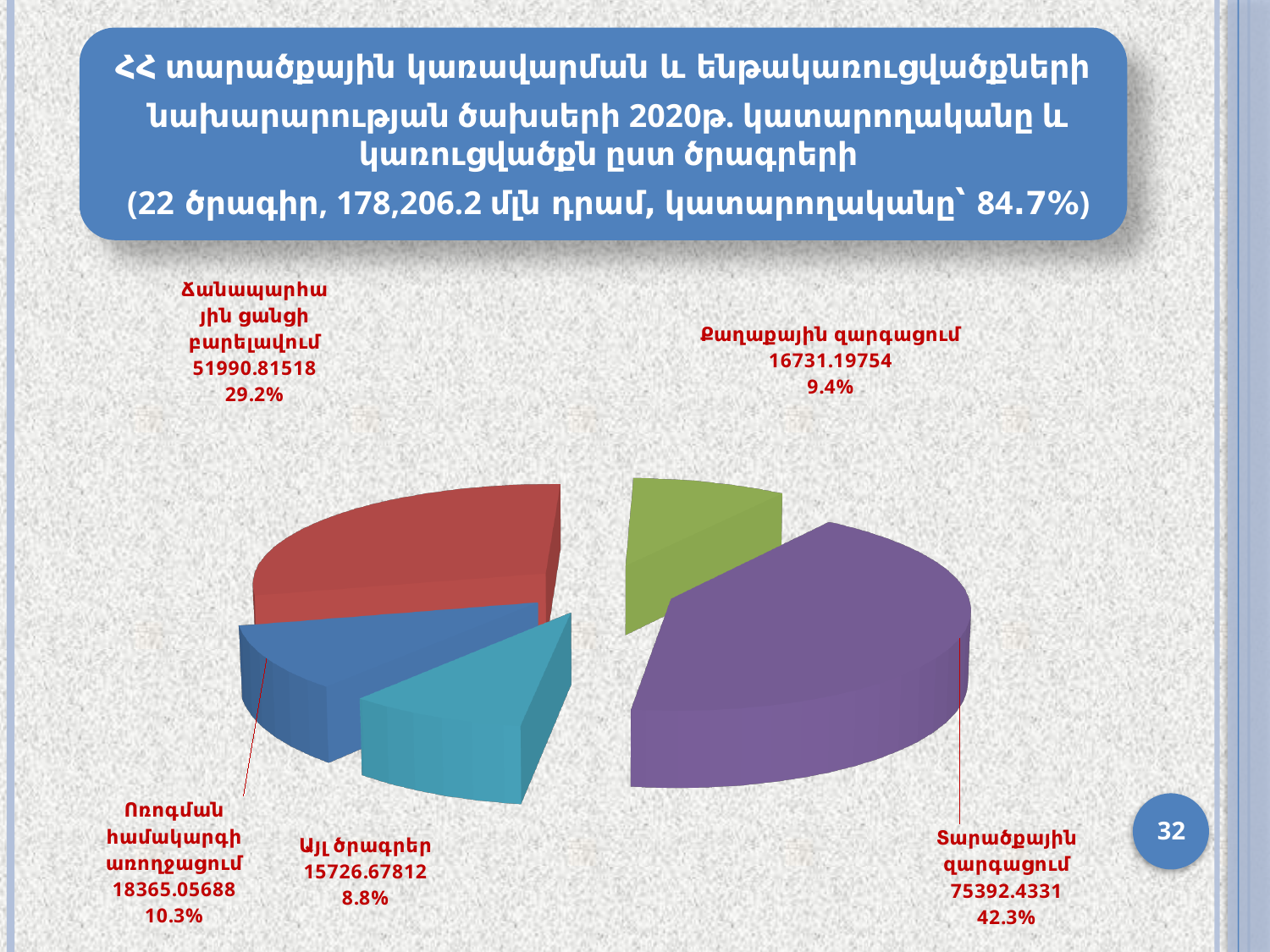
What is the value shown for Տարածքային զարգացում? 75392.4331 What share of the pie does Քաղաքային զարգացում represent? 9.4% Which category has the smallest slice of the pie? Այլ ծրագրեր What is the difference in percentage share between Տարածքային զարգացում and Ճանապարհային ցանցի բարելավում? 13.1% What colour is the slice for Տարածքային զարգացում? Purple What is the value shown for Ճանապարհային ցանցի բարելավում? 51990.81518 What type of chart is shown on the slide? Pie chart Which is larger, the value for Ոռոգման համակարգի առողջացում or the value for Քաղաքային զարգացում? Ոռոգման համակարգի առողջացում Which category has the largest slice of the pie? Տարածքային զարգացում What is the value shown for Ոռոգման համակարգի առողջացում? 18365.05688 How many slices does the pie chart have? 5 What share of the pie does Այլ ծրագրեր represent? 8.8%